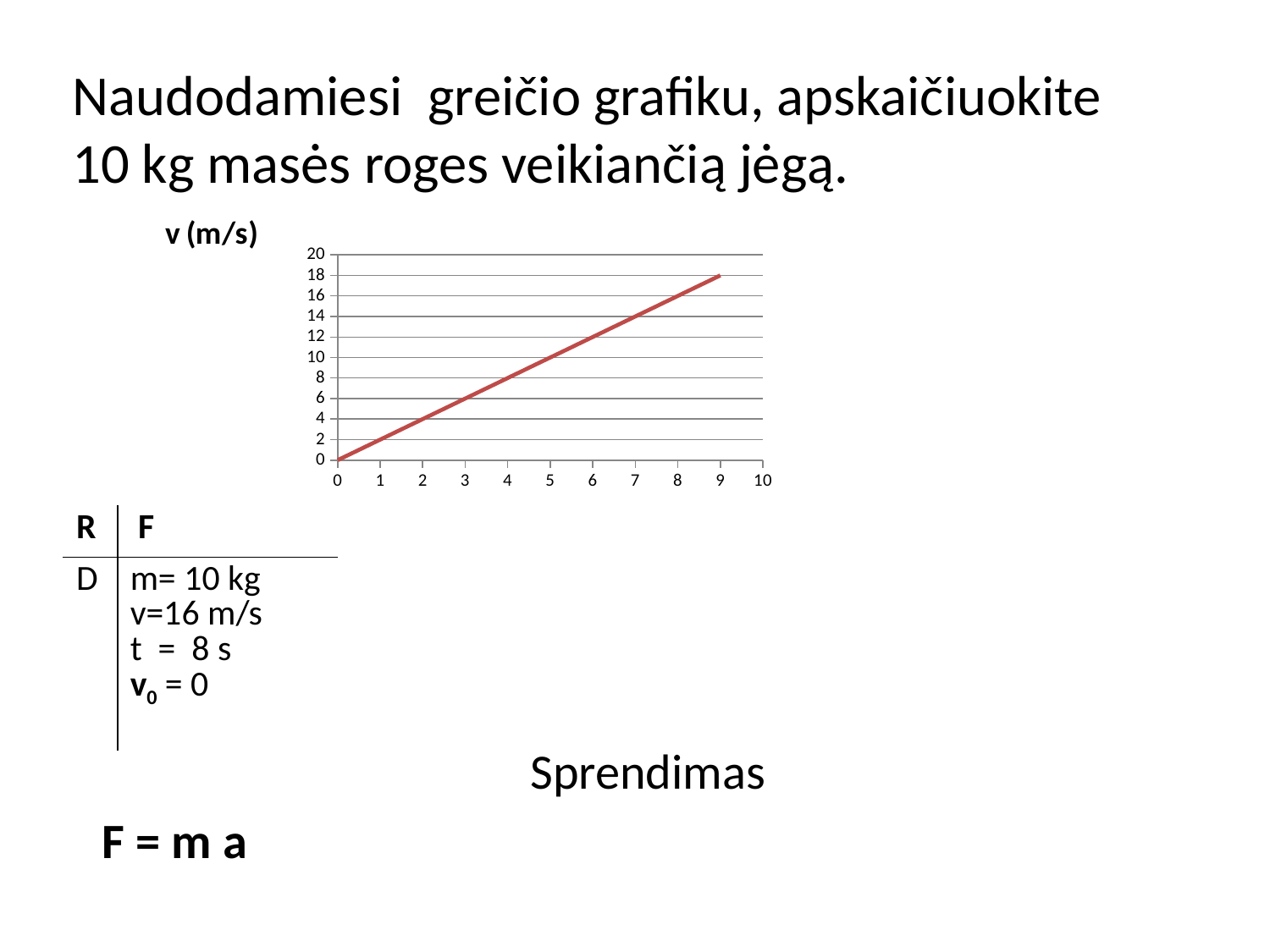
Is the value of v at x = 5 greater or less than 8? greater What is the value of v (m/s) at x = 0? 0 Is the value of v at x = 7 greater or less than 10? greater Is the value of v at x = 3 greater or less than 8? less At which x value is the plotted v highest, x = 0 or x = 9? x = 9 What label is written above the vertical axis of the chart? v (m/s) What is the value of v (m/s) at x = 8? 16 What kind of chart is shown on the slide? line chart What is the highest tick value shown on the vertical axis? 20 What is the value of v (m/s) at the right end of the line, where x = 9? 18 Does the plotted value rise or fall as the x axis increases from 0 to 9? rise